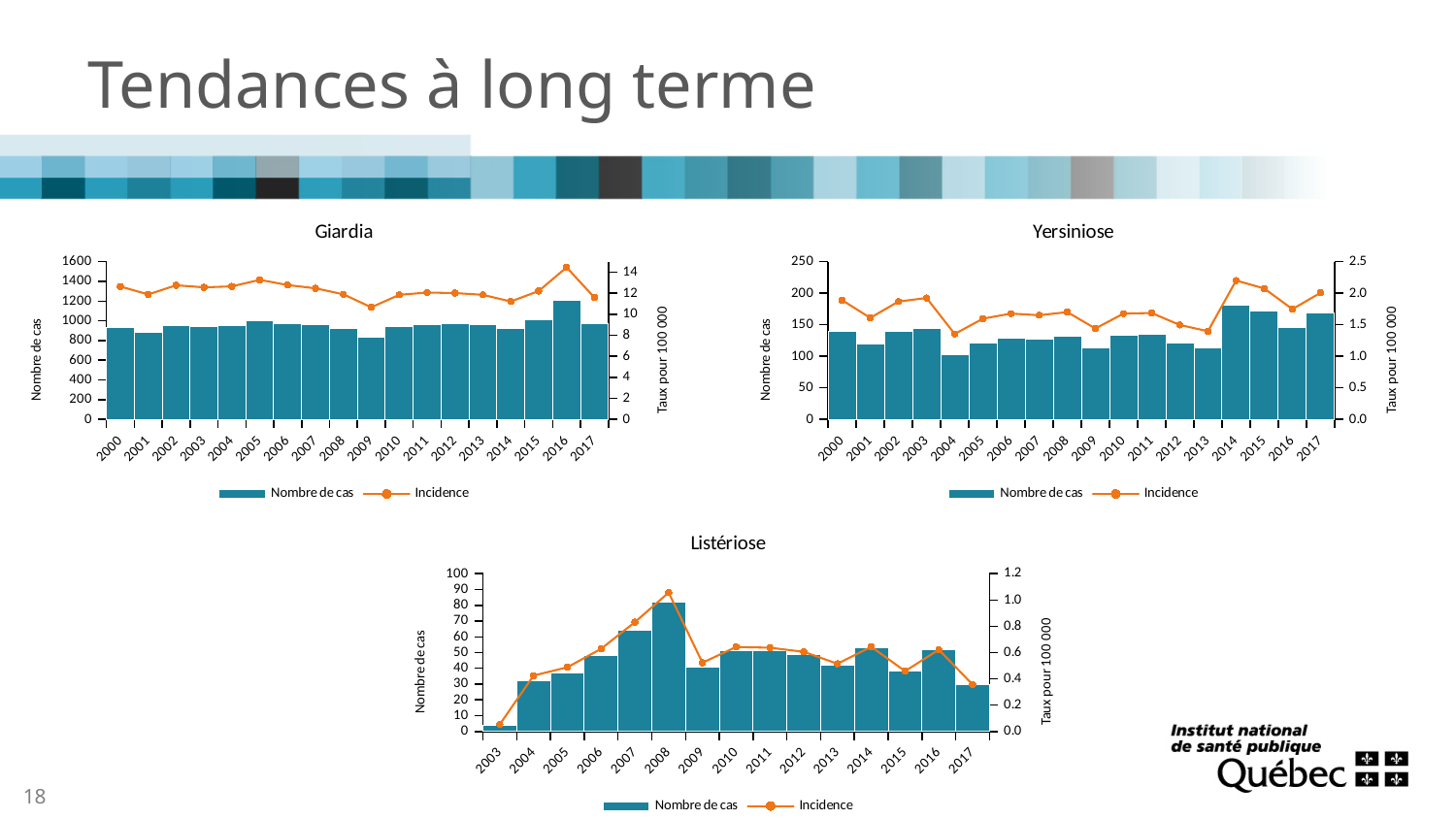
How many charts are on the slide? 3 In the Listériose chart, which year has the highest number of cases? 2008 What are the two legend entries in the Yersiniose chart? Nombre de cas and Incidence In the Listériose chart, is the number of cases for 2003 greater or less than 10? less In the Giardia chart, which year has the highest number of cases? 2016 In the Giardia chart, which year has the lowest incidence rate? 2009 In the Yersiniose chart, which year has the lowest number of cases? 2004 In the Yersiniose chart, which year has the highest number of cases? 2014 In the Giardia chart, is the number of cases for 2016 greater or less than 1000? greater In the Yersiniose chart, is the number of cases for 2004 greater or less than 150? less How many series does the legend of the Giardia chart list? 2 In the Listériose chart, how many years are shown on the x axis? 15